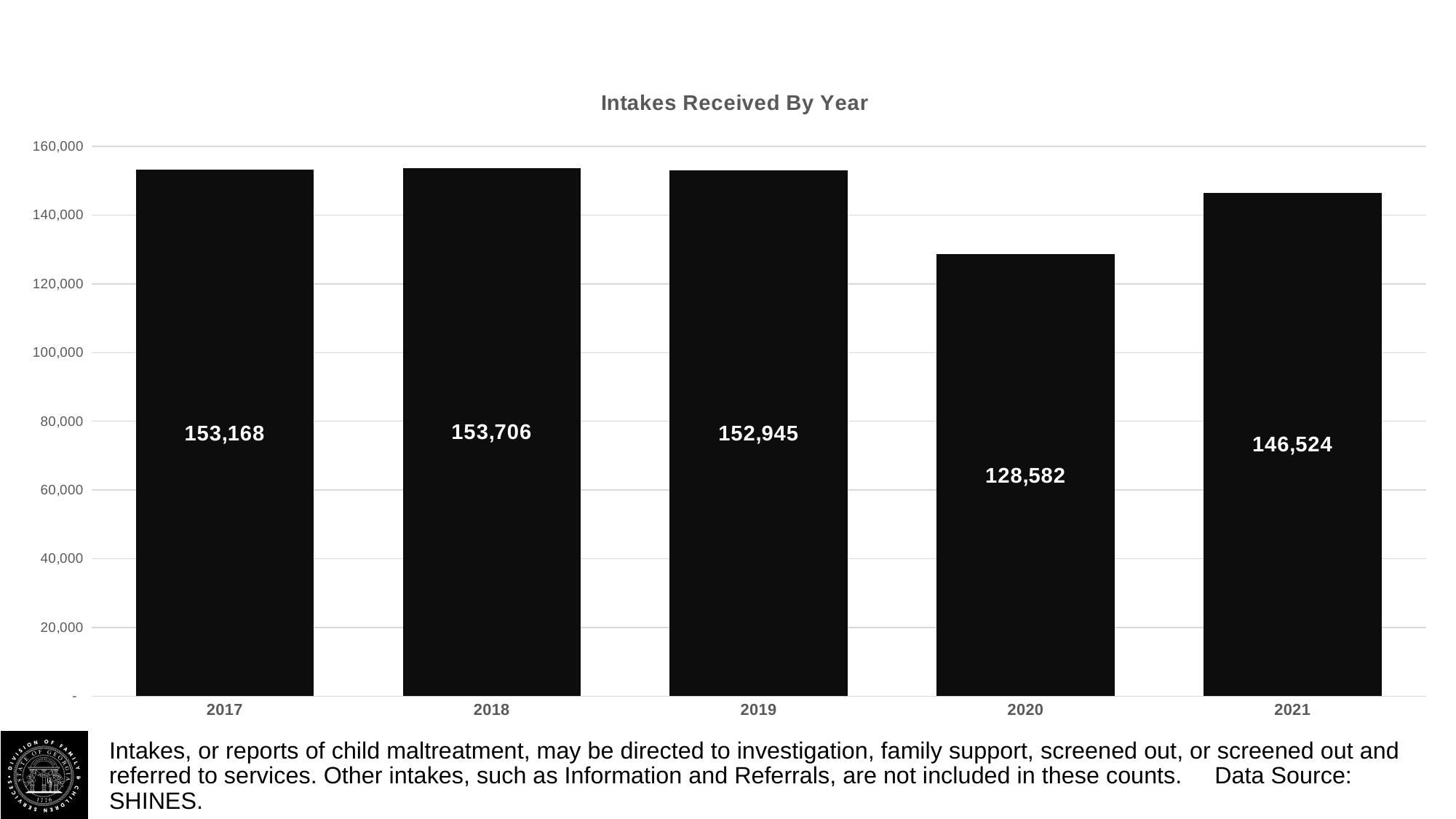
How many years are shown on the x axis of the chart? 5 What is the value shown for 2021? 146,524 What is the difference between the 2018 and 2017 values? 538 What is the difference between the intakes received in 2019 and 2020? 24,363 Which year has the highest number of intakes received? 2018 What is the value for 2017 in the Intakes Received By Year chart? 153,168 Is the value for 2020 greater or less than 140,000? less What kind of chart is shown on the slide? bar chart What is the title of the chart? Intakes Received By Year How many intakes were received in 2020? 128,582 Which year had more intakes received, 2020 or 2021? 2021 Which year has the lowest number of intakes received? 2020